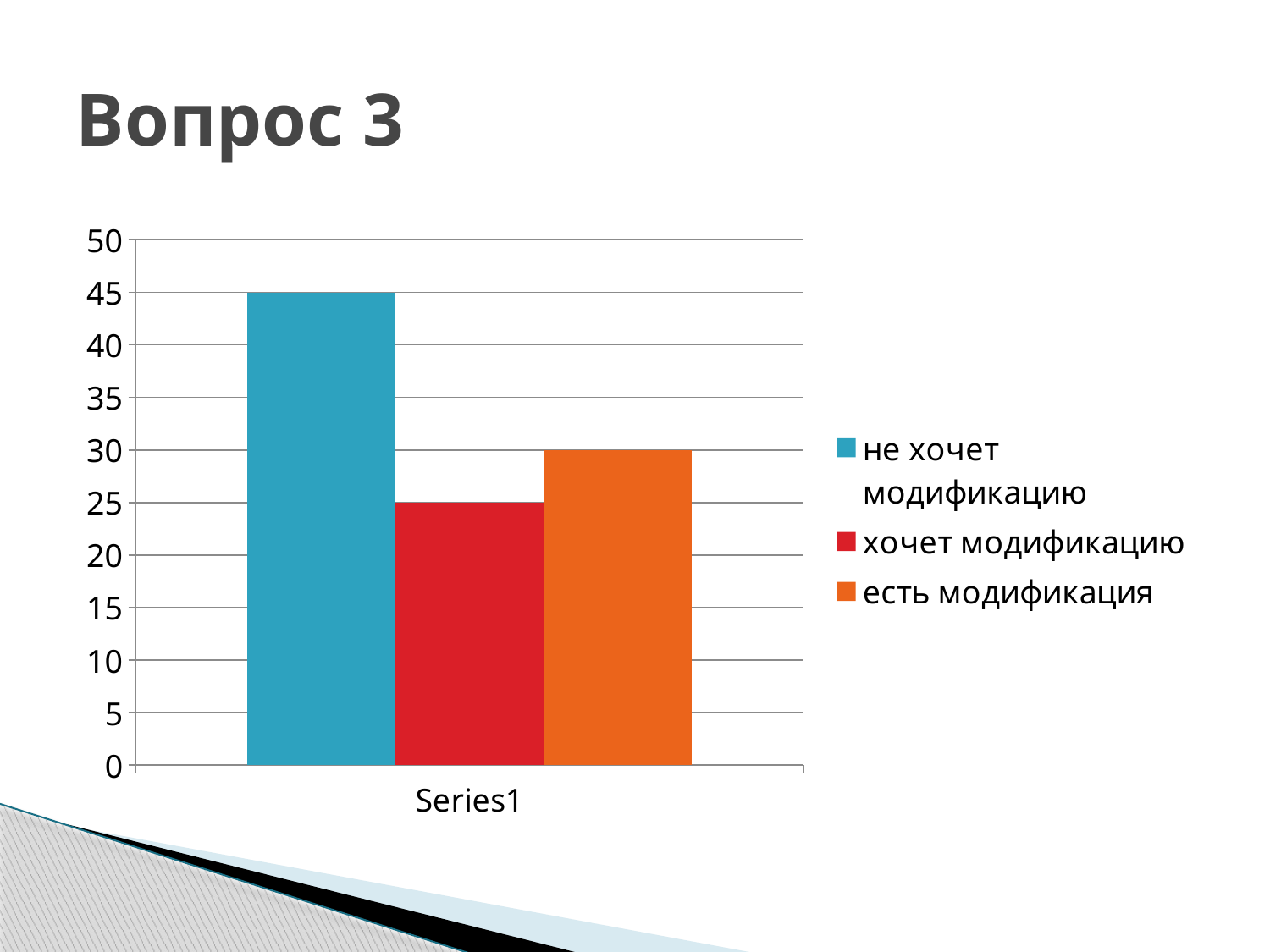
Which legend entry has the highest value? не хочет модификацию Is the value for "не хочет модификацию" greater or less than 40? greater What is the difference between the values for "не хочет модификацию" and "хочет модификацию"? 20 Which is larger, the value for "есть модификация" or the value for "хочет модификацию"? есть модификация What kind of chart is shown on the slide? bar chart What is the difference between the values for "есть модификация" and "хочет модификацию"? 5 What is the value for "есть модификация"? 30 What is the value for "не хочет модификацию"? 45 Which legend entry has the lowest value? хочет модификацию What is the title of the slide? Вопрос 3 How many series does the legend list? 3 What is the value for "хочет модификацию"? 25